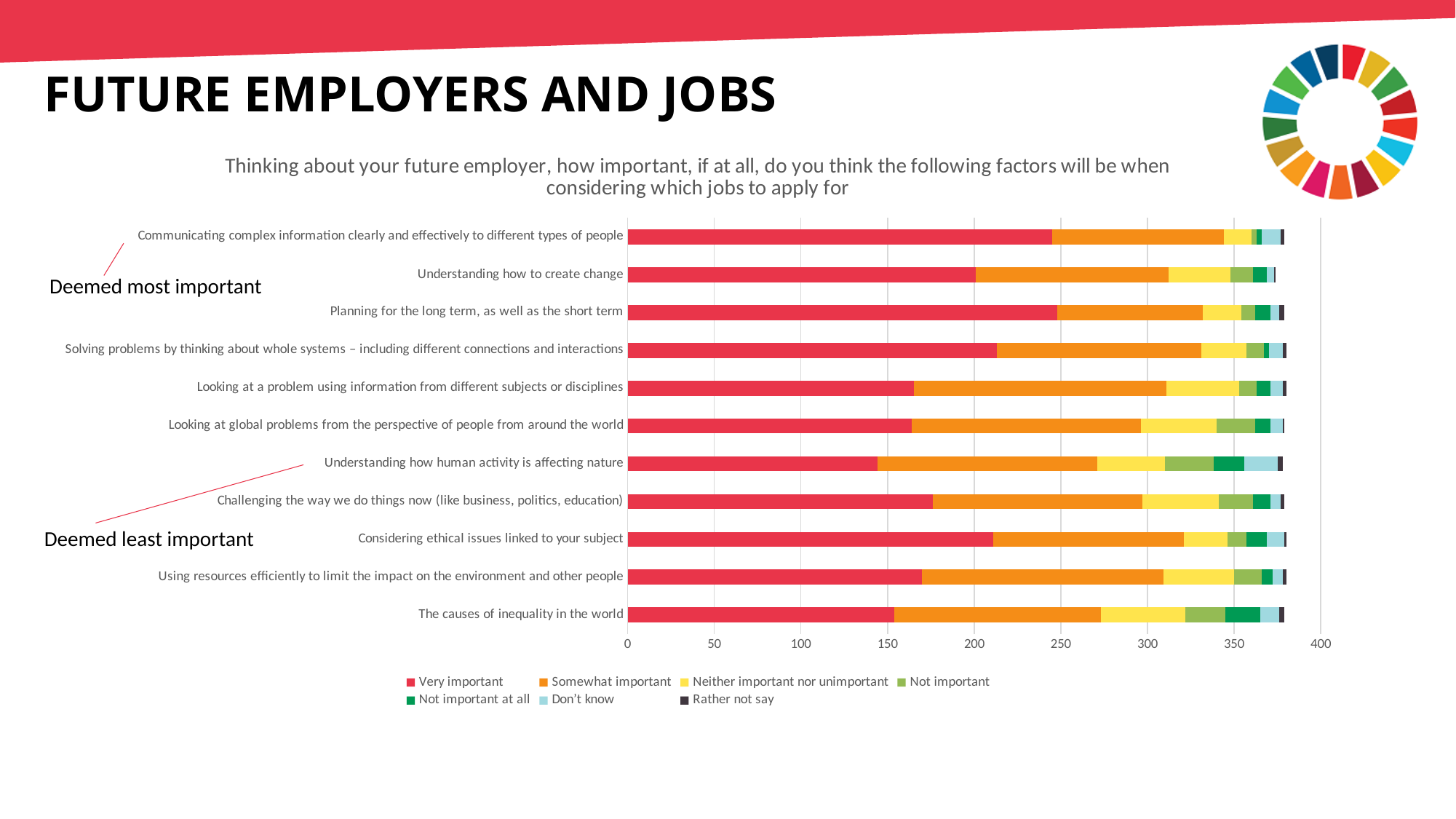
Which category is labelled 'Deemed most important' on the slide? Communicating complex information clearly and effectively to different types of people Is the 'Very important' value for 'Understanding how human activity is affecting nature' greater or less than 150? less Is the 'Very important' value for 'Communicating complex information clearly and effectively to different types of people' greater or less than 200? greater What kind of chart is shown on the slide? Stacked bar chart How many factors (categories) are plotted in the chart? 11 Which has the larger 'Very important' value: 'Communicating complex information clearly and effectively to different types of people' or 'Understanding how human activity is affecting nature'? Communicating complex information clearly and effectively to different types of people What is the maximum value shown on the horizontal axis of the chart? 400 Is the 'Very important' value for 'Looking at a problem using information from different subjects or disciplines' greater or less than 200? less Which has the larger 'Very important' value: 'Considering ethical issues linked to your subject' or 'Using resources efficiently to limit the impact on the environment and other people'? Considering ethical issues linked to your subject How many series does the chart legend list? 7 Which legend entry is shown in red in the chart? Very important